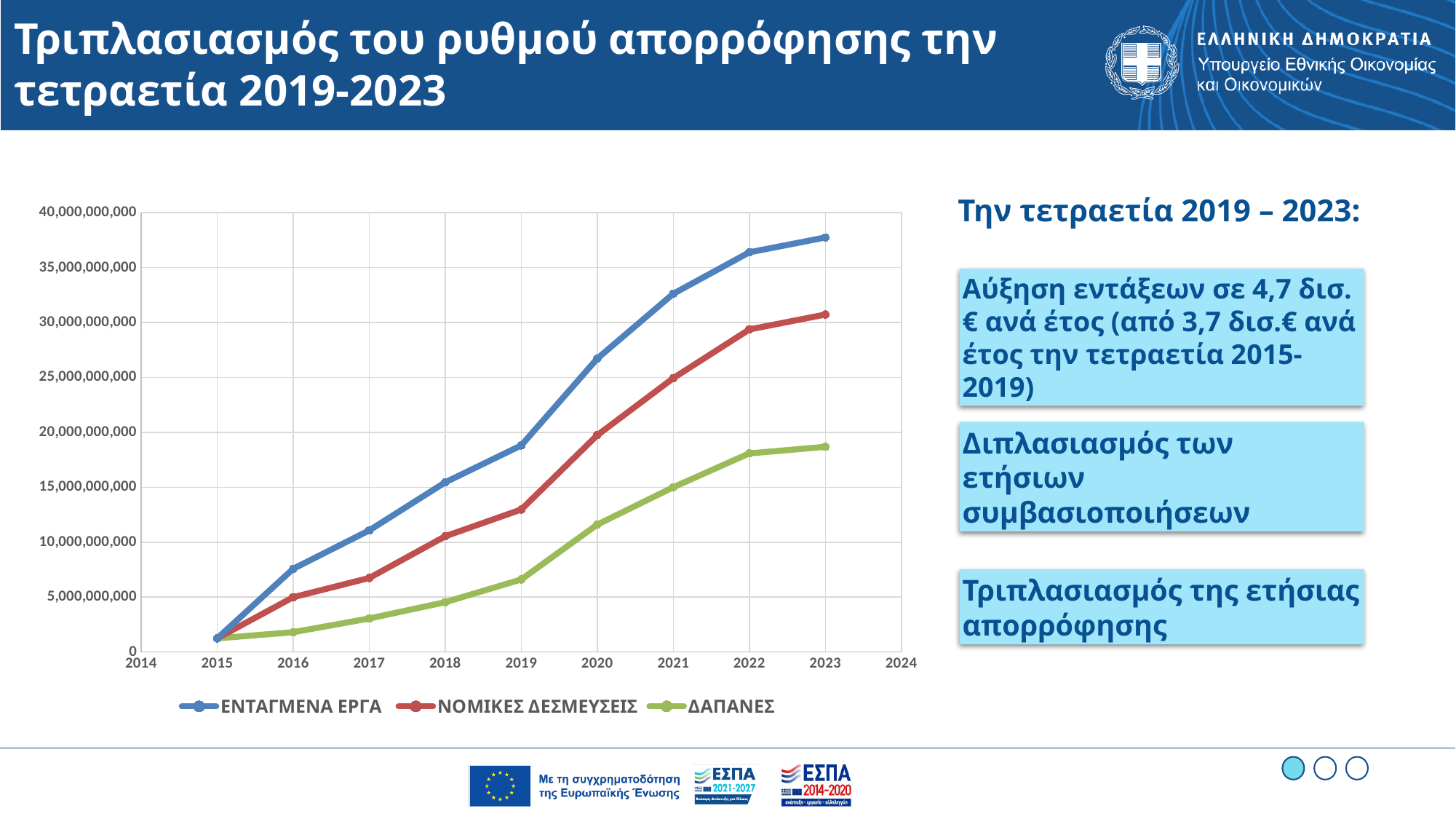
How many series does the chart legend list? 3 Is the value for ΔΑΠΑΝΕΣ in 2023 greater or less than 20,000,000,000? less What kind of chart is shown on the slide? line chart Is the value for ΔΑΠΑΝΕΣ in 2019 greater or less than 5,000,000,000? greater Which series has the lowest value in 2023? ΔΑΠΑΝΕΣ Is the value for ΕΝΤΑΓΜΕΝΑ ΕΡΓΑ in 2019 greater or less than 20,000,000,000? less Which series has the highest value in 2023? ΕΝΤΑΓΜΕΝΑ ΕΡΓΑ What colour is the line for ΔΑΠΑΝΕΣ? green Do the values for ΕΝΤΑΓΜΕΝΑ ΕΡΓΑ rise or fall from 2015 to 2023? rise How many yearly data points are plotted for each series? 9 In 2020, which is larger: ΝΟΜΙΚΕΣ ΔΕΣΜΕΥΣΕΙΣ or ΔΑΠΑΝΕΣ? ΝΟΜΙΚΕΣ ΔΕΣΜΕΥΣΕΙΣ